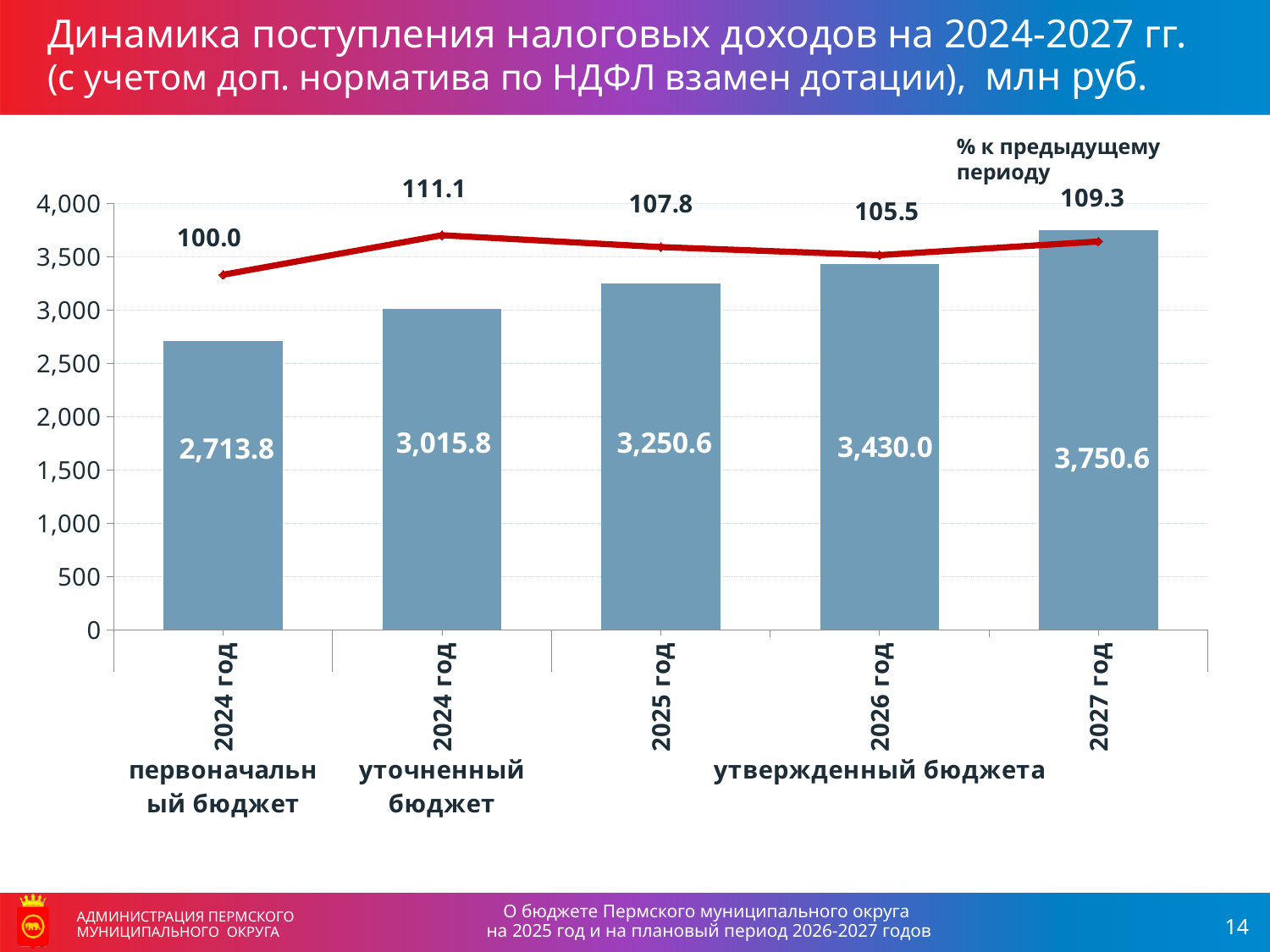
Do the bar values rise or fall from left to right along the x axis? rise What is the '% к предыдущему периоду' value shown for 2026 год? 105.5 Which category has the highest bar value? 2027 год Which category has the lowest bar value? 2024 год (первоначальный бюджет) What is the difference between the bar values for 2027 год and 2026 год? 320.6 Which is larger: the bar value for 2025 год or for 2024 год (уточненный бюджет)? 2025 год What unit of measurement is stated in the chart title? млн руб. How many bars are plotted in the chart? 5 What is the tax revenue value for 2025 год? 3,250.6 What is the '% к предыдущему периоду' value shown for 2027 год? 109.3 What is the value for 2024 год (первоначальный бюджет)? 2,713.8 What is the value for 2024 год (уточненный бюджет)? 3,015.8